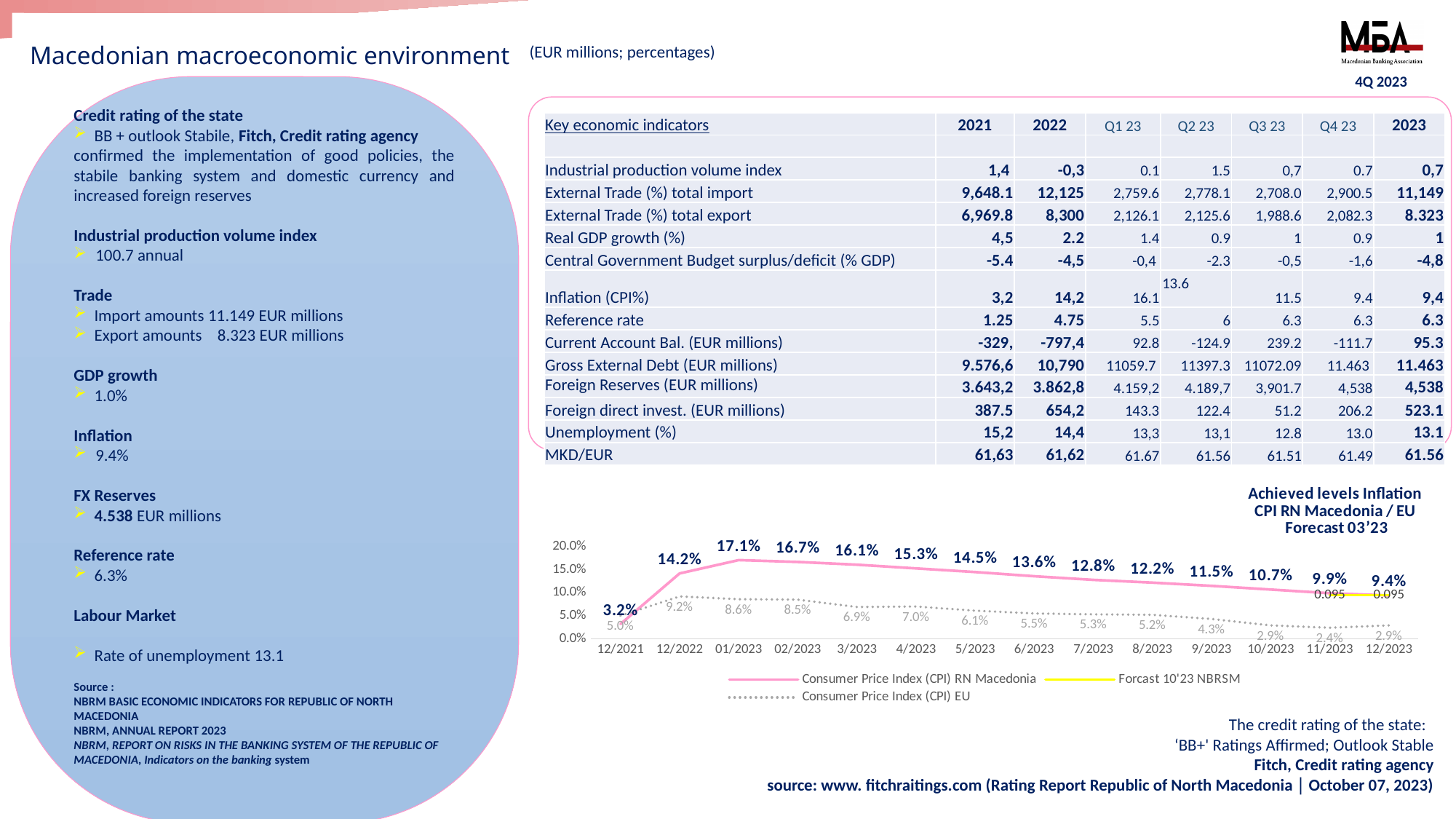
What is the difference between the CPI RN Macedonia value and the CPI EU value for 6/2023? 8.1% What is the Consumer Price Index (CPI) RN Macedonia value for 01/2023? 17.1% At which date is the Consumer Price Index (CPI) RN Macedonia series at its lowest value? 12/2021 What is the Consumer Price Index (CPI) EU value for 12/2022? 9.2% Does the Consumer Price Index (CPI) RN Macedonia series rise or fall from 01/2023 to 12/2023? fall Which is larger for 12/2021: the CPI RN Macedonia value or the CPI EU value? CPI EU How many series does the chart legend list? 3 What is the value of the Forcast 10'23 NBRSM series at 11/2023? 0.095 At which date does the Consumer Price Index (CPI) RN Macedonia series reach its highest value? 01/2023 What type of chart is shown on the slide? line chart How many points are plotted along the x axis of the chart? 14 What is the Consumer Price Index (CPI) RN Macedonia value for 12/2023? 9.4%